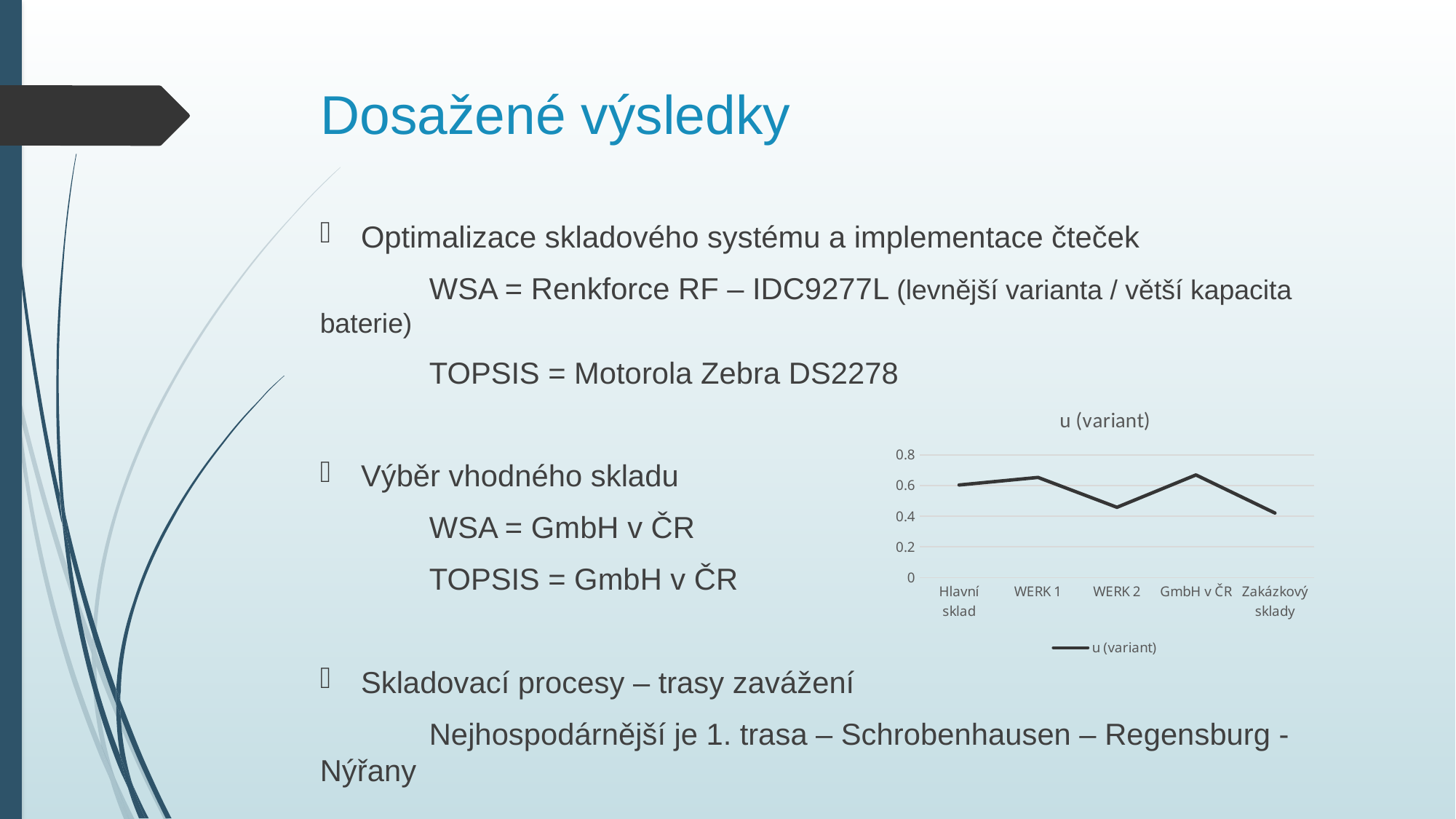
Is the value for WERK 2 greater or less than 0.6? less Which category has the lowest value in the chart? Zakázkový sklady Which has the larger value, GmbH v ČR or Zakázkový sklady? GmbH v ČR Is the value for Hlavní sklad greater or less than 0.4? greater What kind of chart is shown on the slide? line chart Is the value for Zakázkový sklady greater or less than 0.6? less How many categories are plotted on the x axis of the chart? 5 Does the value rise or fall from GmbH v ČR to Zakázkový sklady? fall What is the title of the chart? u (variant) How many series does the chart's legend list? 1 Which has the larger value, WERK 1 or WERK 2? WERK 1